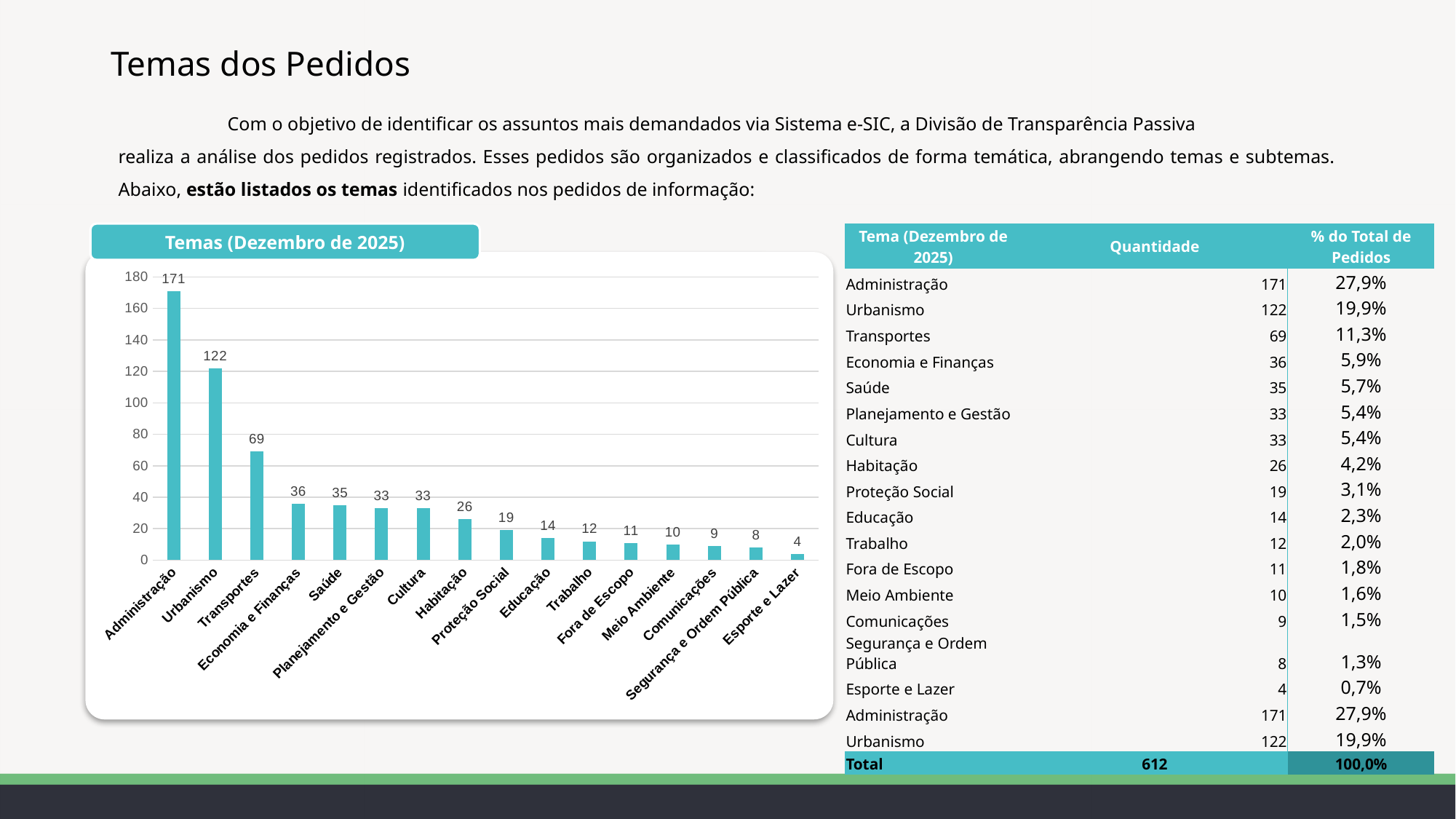
What is the value for Transportes in the chart? 69 Is the value for Urbanismo greater or less than 100? greater Which is larger, the value for Proteção Social or the value for Educação? Proteção Social What is the value for Meio Ambiente in the chart? 10 What kind of chart is shown on the slide? bar chart What is the difference between the values for Transportes and Economia e Finanças? 33 Which category has the highest value in the chart? Administração Which category has the lowest value in the chart? Esporte e Lazer What is the title of the chart? Temas (Dezembro de 2025) How many categories are shown in the chart? 16 What is the difference between the values for Administração and Urbanismo? 49 What is the value for Habitação in the chart? 26